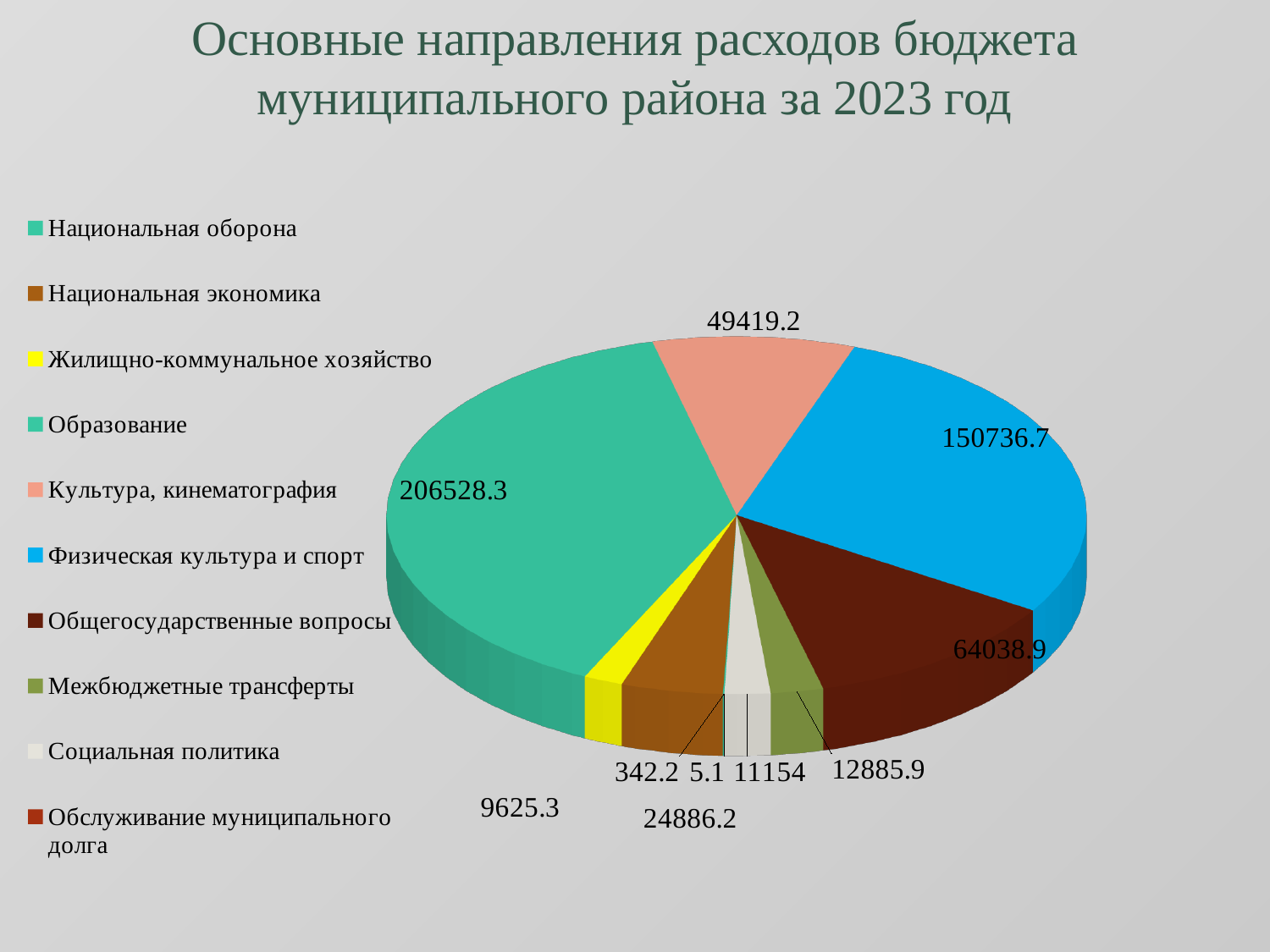
What is the value shown for Межбюджетные трансферты? 12885.9 Which category has the largest slice of the pie? Образование What is the value shown for Общегосударственные вопросы? 64038.9 How many categories does the legend of the pie chart list? 10 Which is larger, the value for Национальная экономика or for Жилищно-коммунальное хозяйство? Национальная экономика What is the smallest value printed on the pie chart? 5.1 What type of chart is shown on the slide? pie chart What is the difference between the values for Образование and Физическая культура и спорт? 55791.6 What is the value shown for Физическая культура и спорт? 150736.7 What is the value shown for Образование? 206528.3 What is the value shown for Социальная политика? 11154 What is the value shown for Культура, кинематография? 49419.2